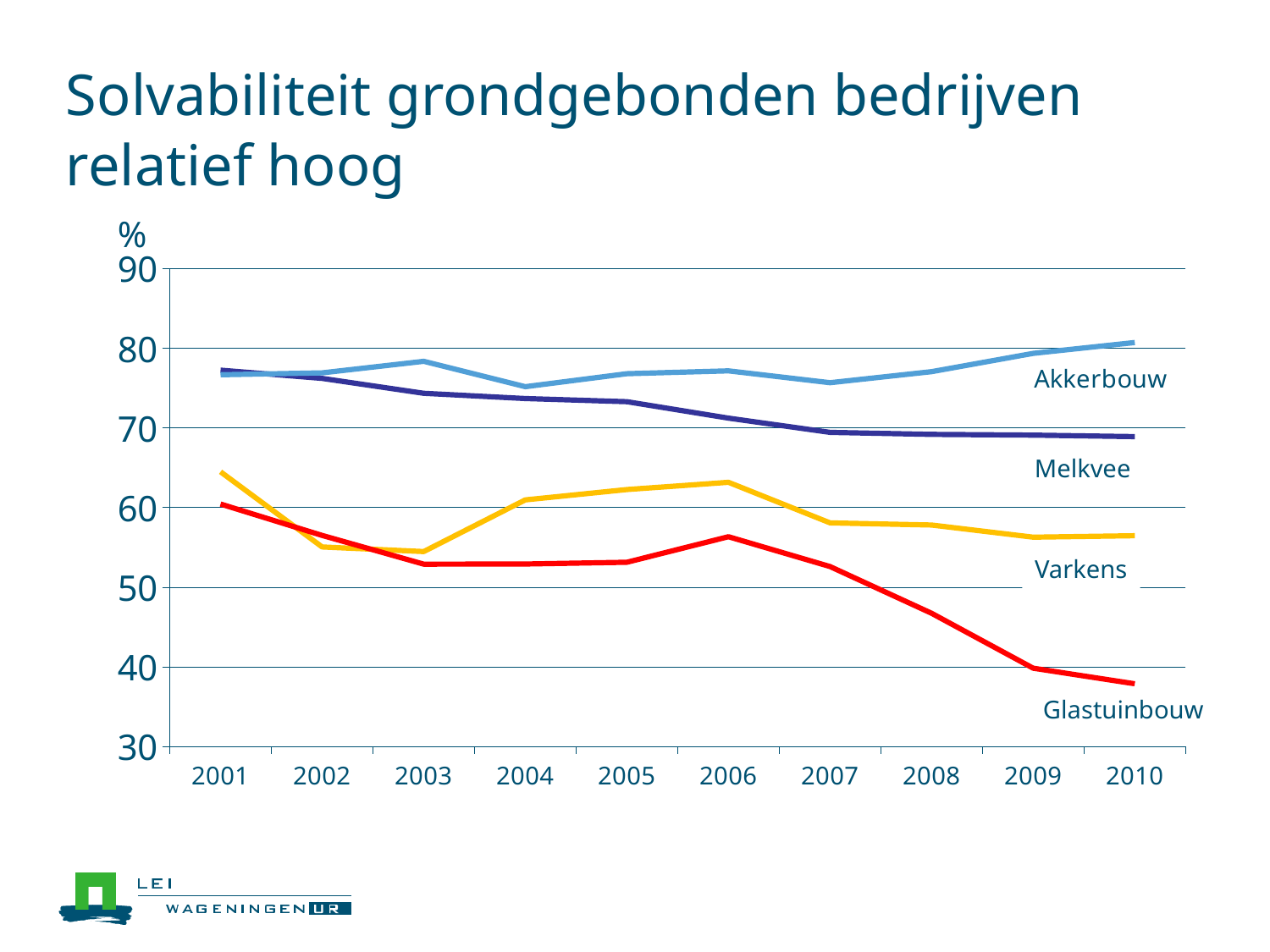
Is the value for Varkens in 2001 greater or less than 60? greater What unit is shown at the top of the y axis? % Does the Glastuinbouw line rise or fall overall from 2001 to 2010? fall Which series has the lowest value in 2010? Glastuinbouw In 2006, which is larger: the value for Varkens or the value for Glastuinbouw? Varkens Is the value for Glastuinbouw in 2008 greater or less than 50? less Is the value for Glastuinbouw in 2010 greater or less than 40? less Which series has the highest value in 2010? Akkerbouw How many years are shown along the x axis of the chart? 10 Which series has the lowest value in 2001? Glastuinbouw How many series (lines) are labelled on the chart? 4 What kind of chart is shown on the slide? line chart